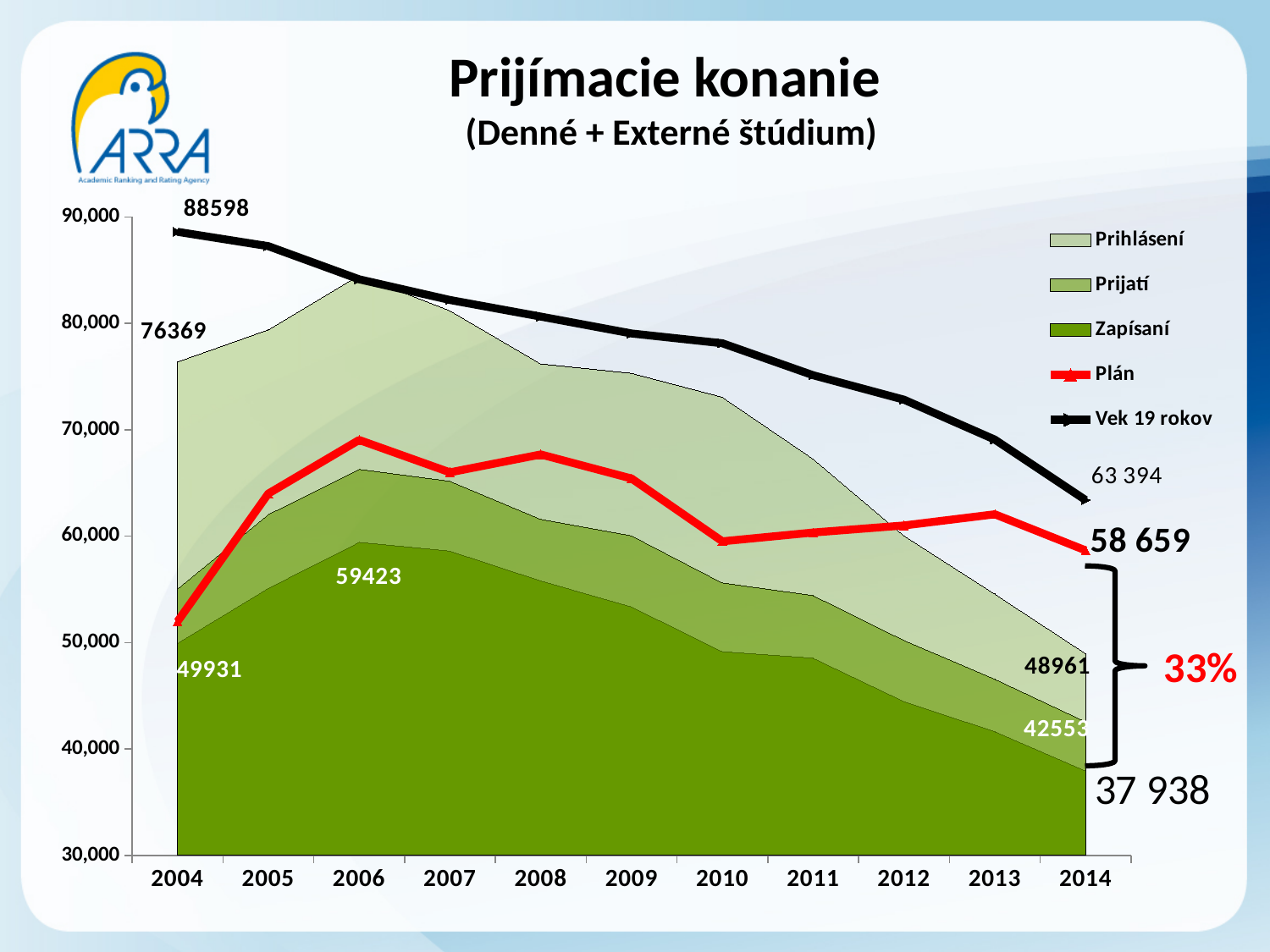
Is the value of Plán in 2006 greater or less than 60,000? greater What is the value of Prihlásení in 2004? 76369 What is the value of Plán in 2014? 58 659 What kind of chart is shown on the slide? combination area and line chart What is the value of Zapísaní in 2014? 37 938 In which year does Zapísaní reach its highest value? 2006 By how much did Vek 19 rokov decrease from 2004 to 2014? 25204 How many years are shown on the x axis? 11 What is the value of Zapísaní in 2006? 59423 How many series does the legend list? 5 What is the value of Vek 19 rokov in 2004? 88598 Does the Vek 19 rokov line rise or fall from 2004 to 2014? fall